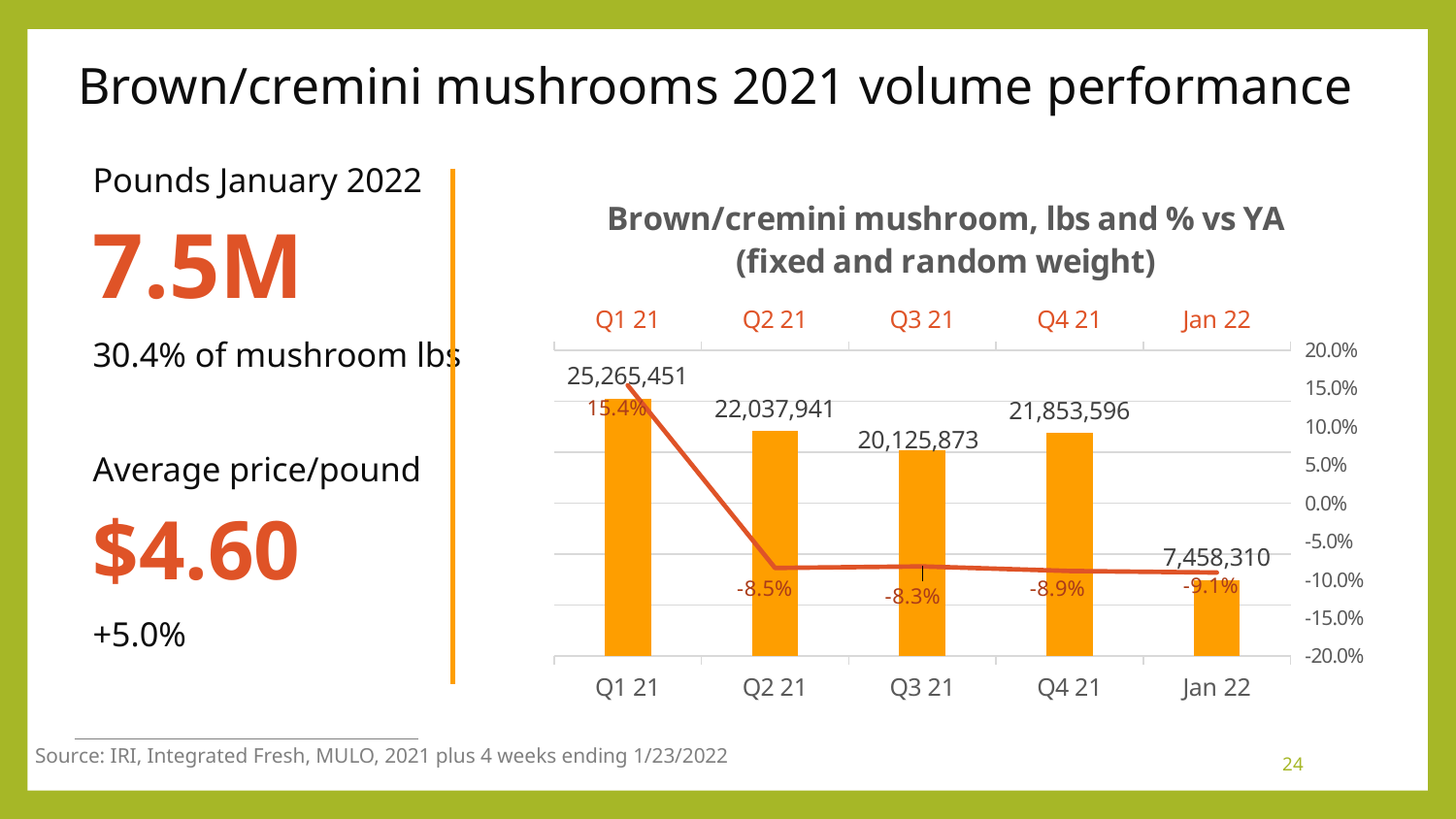
Which has a larger volume in pounds, Q2 21 or Q4 21? Q2 21 What is the difference in pounds between Q2 21 and Q3 21? 1,912,068 What is the volume in pounds for Q3 21? 20,125,873 What is the title of the chart? Brown/cremini mushroom, lbs and % vs YA (fixed and random weight) What is the % vs YA value for Q2 21? -8.5% Which period has the highest volume in pounds? Q1 21 What is the volume in pounds for Q1 21? 25,265,451 How many periods are shown on the x axis? 5 What is the % vs YA value for Jan 22? -9.1% What kind of chart is shown on the slide? Bar chart with a line Does the % vs YA line rise or fall from Q1 21 to Q2 21? Fall Which period has the lowest volume in pounds? Jan 22